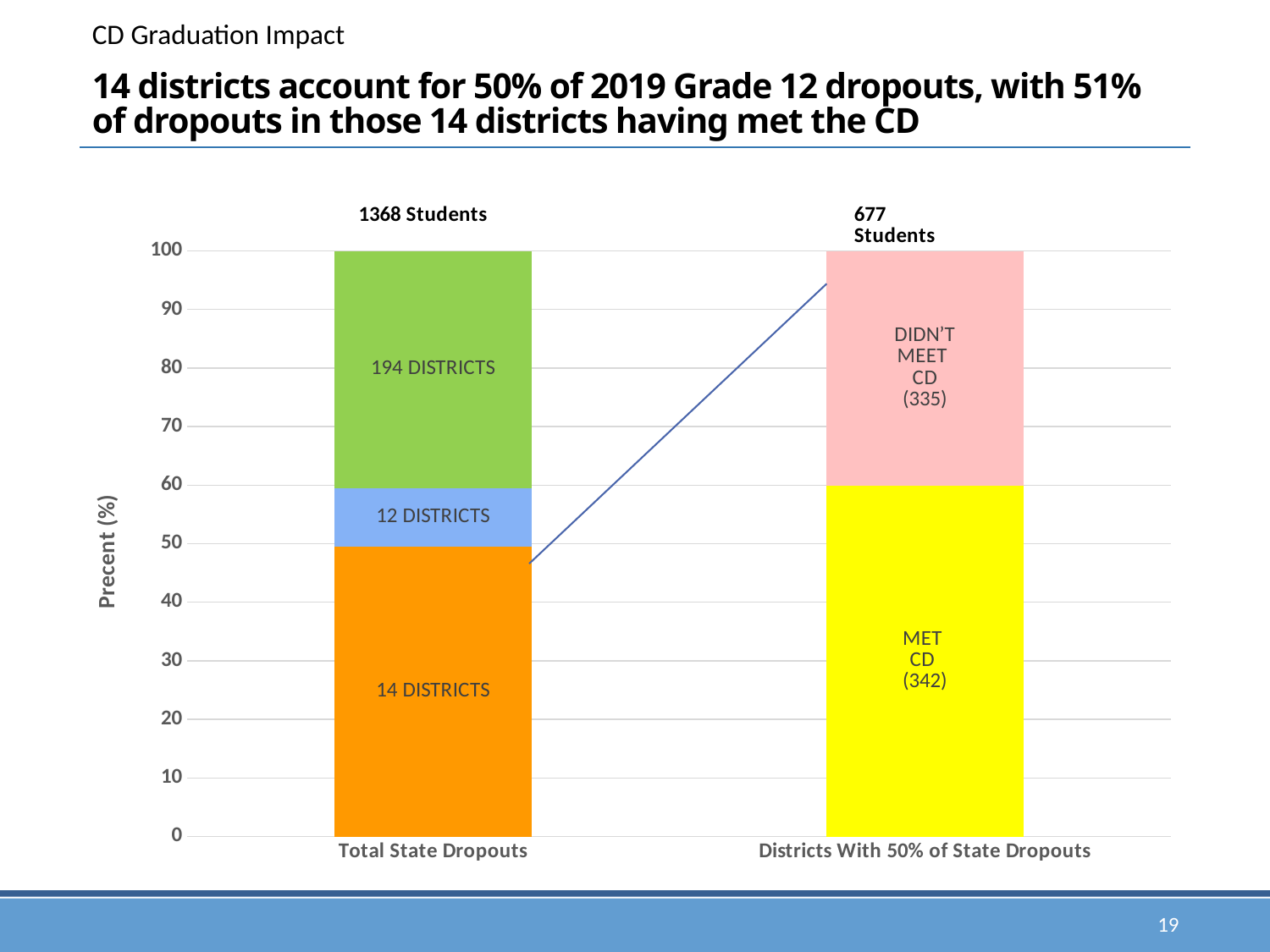
How many students does the 'Total State Dropouts' bar represent, according to the label above it? 1368 Students What is the difference in students between the 'MET CD' segment (342) and the 'DIDN'T MEET CD' segment (335)? 7 How many students are in the 'DIDN'T MEET CD' segment? 335 How many segments make up the 'Total State Dropouts' bar? 3 Is the top of the 'MET CD' segment greater or less than 50 on the percent axis? greater How many bars (categories) are plotted on the x axis? 2 What is the total number of students in the 'Districts With 50% of State Dropouts' bar, summing the MET CD and DIDN'T MEET CD segments? 677 Which segment has more students, 'MET CD' or 'DIDN'T MEET CD'? MET CD How many students does the 'Districts With 50% of State Dropouts' bar represent, according to the label above it? 677 Students How many students are in the 'MET CD' segment? 342 Is the top of the '14 DISTRICTS' segment in the 'Total State Dropouts' bar greater or less than 40 on the percent axis? greater What kind of chart is shown on the slide? Stacked bar chart